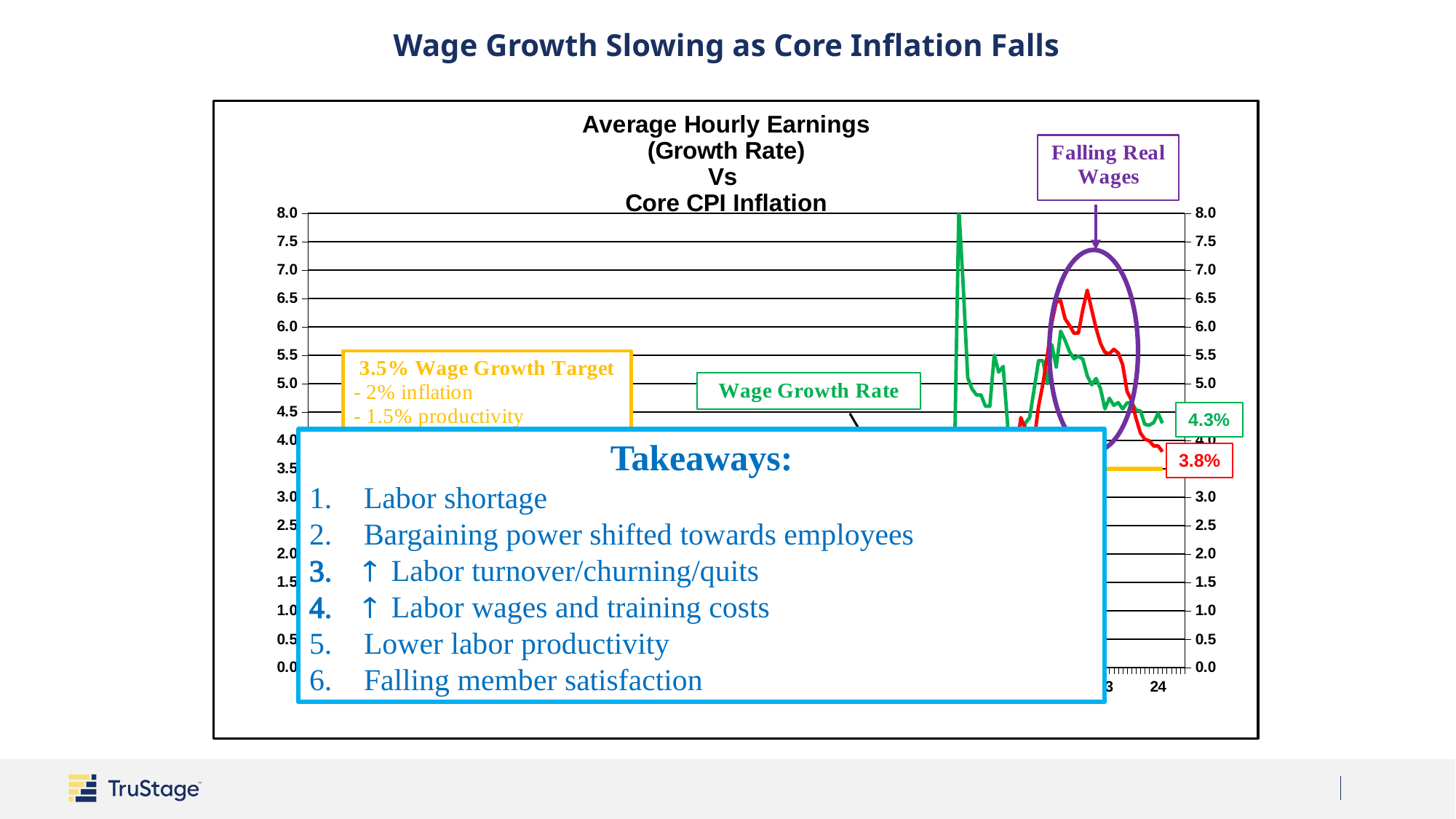
What is the difference between the latest labelled Wage Growth Rate (4.3%) and the latest labelled Core CPI Inflation (3.8%)? 0.5 percentage points What is the latest labelled value of the red Core CPI Inflation line? 3.8% What is the highest value shown on the chart's vertical axis? 8.0 Is the peak of the red Core CPI Inflation line greater or less than 6.0? greater Is the latest Wage Growth Rate value of 4.3% greater or less than the 3.5% Wage Growth Target shown on the chart? greater What kind of chart is shown on the slide? line chart At the end of the series, which is larger: the Wage Growth Rate or Core CPI Inflation? Wage Growth Rate Is the peak of the green Wage Growth Rate line greater or less than 7.0? greater What is the latest labelled value of the Wage Growth Rate (green line)? 4.3% Is the peak of the red Core CPI Inflation line greater or less than 7.0? less What wage growth target is annotated on the chart? 3.5% Wage Growth Target